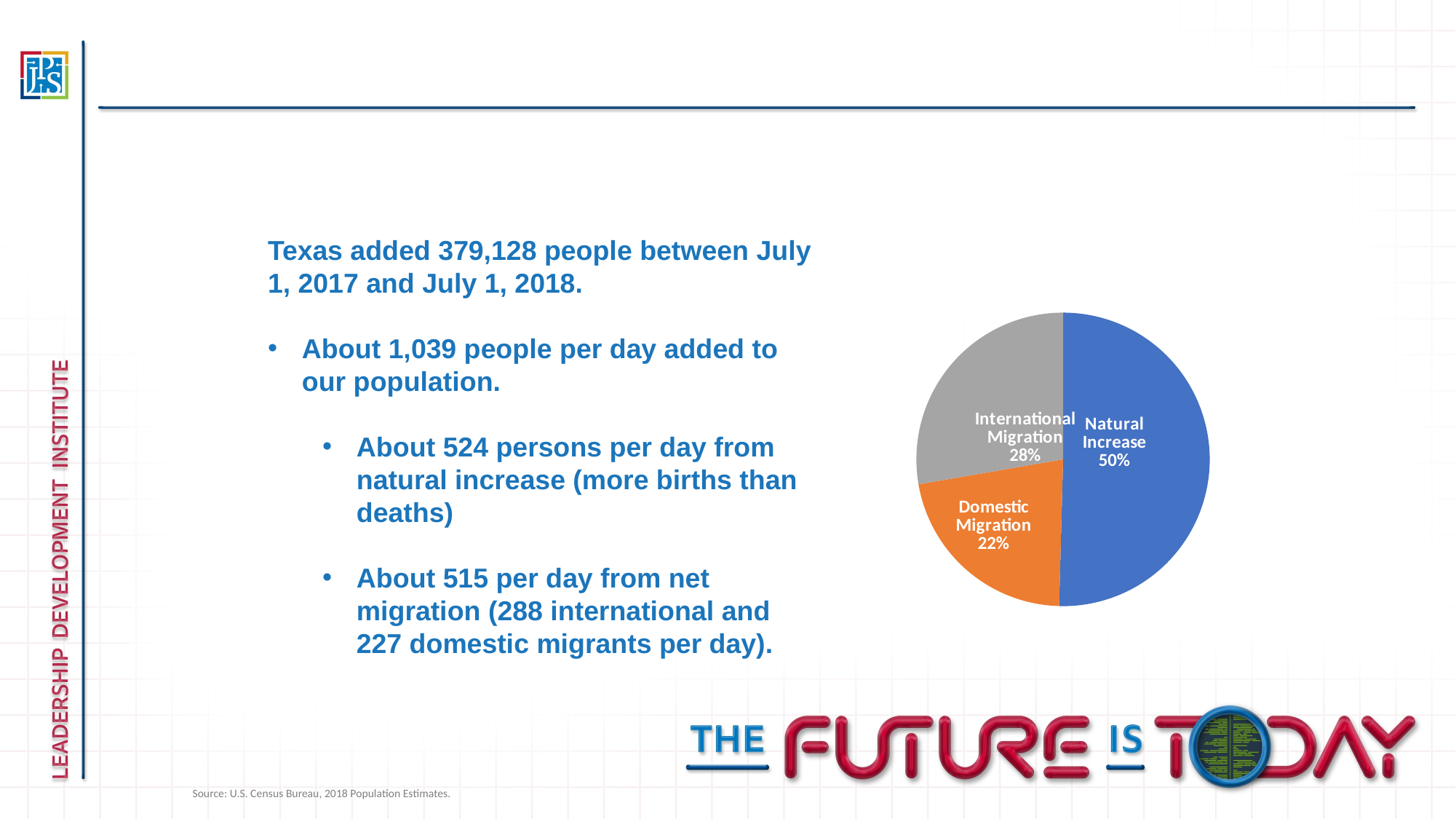
What share of the pie does International Migration represent? 28% Which is larger, the International Migration slice or the Domestic Migration slice? International Migration What colour is the Domestic Migration slice? orange Which slice of the pie chart is the smallest? Domestic Migration What share of the pie does Natural Increase represent? 50% What share of the pie does Domestic Migration represent? 22% What is the difference in percentage points between International Migration and Domestic Migration? 6 What is the difference in percentage points between Natural Increase and International Migration? 22 Which slice of the pie chart is the largest? Natural Increase How many slices does the pie chart have? 3 What colour is the Natural Increase slice? blue What kind of chart is shown on the slide? pie chart